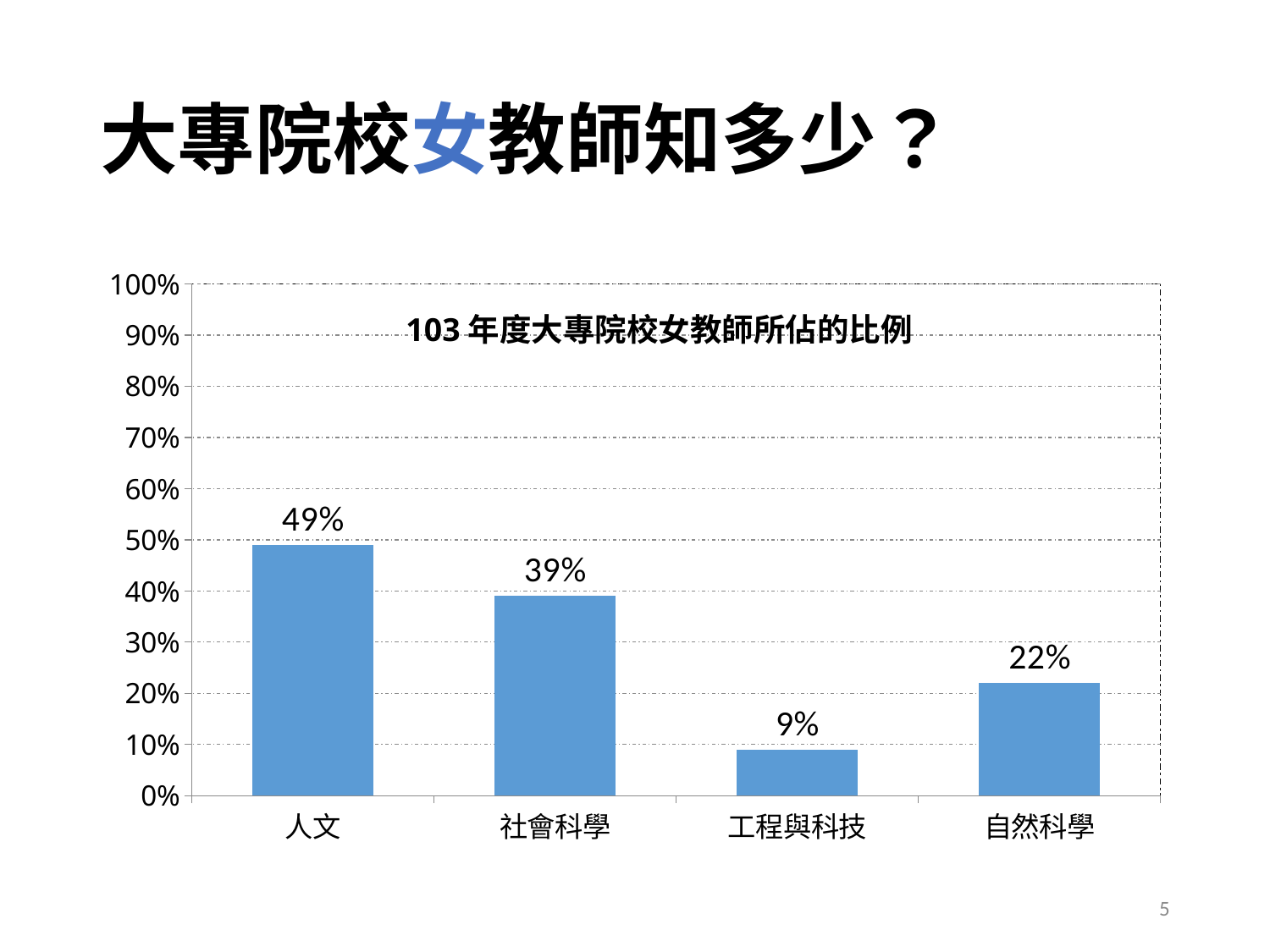
Which is larger, the value for 社會科學 or the value for 自然科學? 社會科學 What is the difference between the values for 人文 and 社會科學? 10% What is the value for 社會科學? 39% How many categories are shown on the x axis? 4 What is the difference between the values for 自然科學 and 工程與科技? 13% What is the title of the chart? 103 年度大專院校女教師所佔的比例 What is the value for 工程與科技? 9% What is the value for 自然科學? 22% What kind of chart is shown on the slide? Bar chart What is the value for 人文? 49% Which category has the highest value? 人文 Which category has the lowest value? 工程與科技